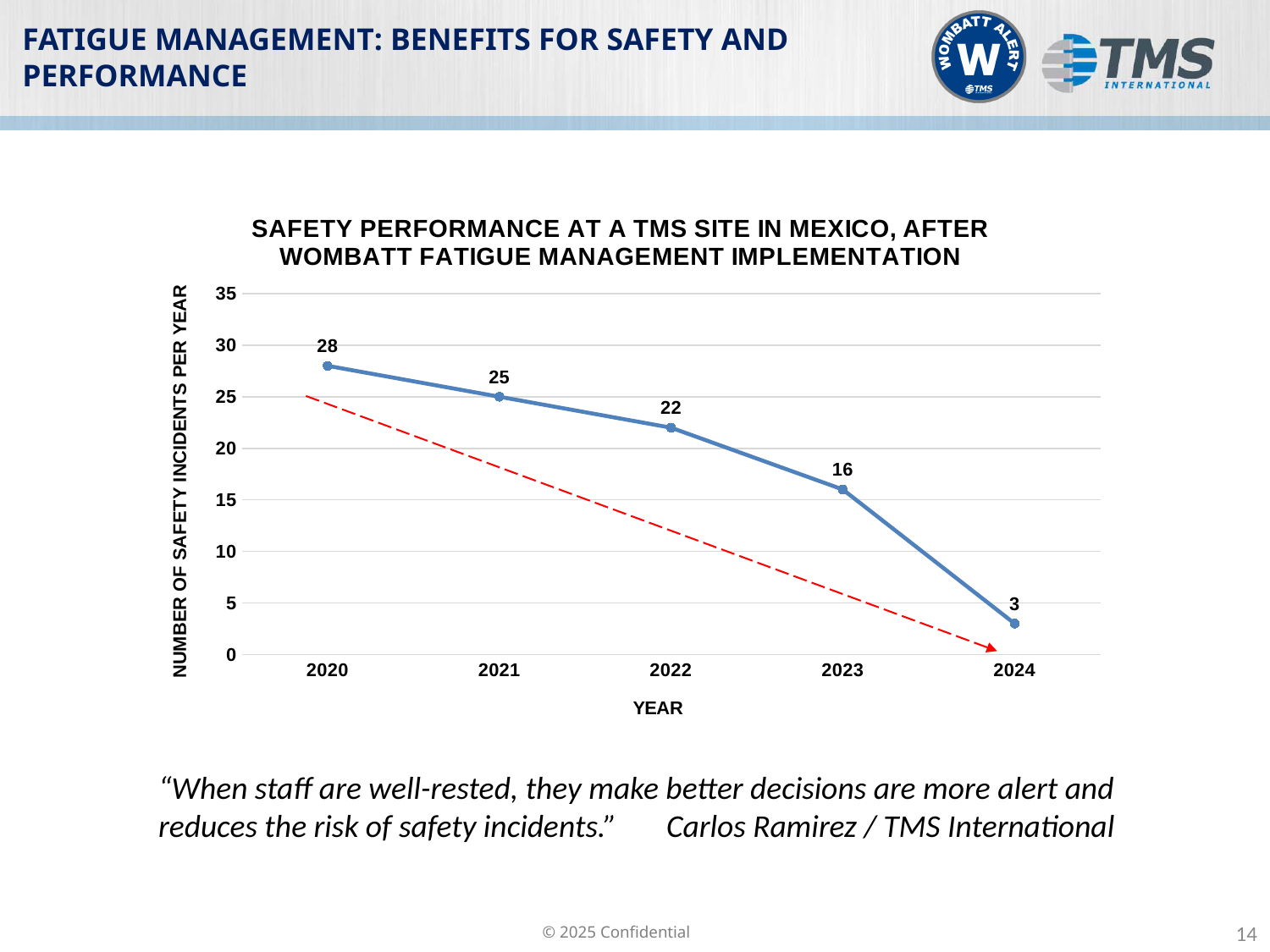
How many years are plotted on the x axis? 5 Do the number of safety incidents rise or fall from 2020 to 2024? fall What is the number of safety incidents per year for 2024? 3 What is the difference in safety incidents between 2020 and 2021? 3 What is the difference in safety incidents between 2023 and 2024? 13 What is the number of safety incidents per year for 2022? 22 Is the value for 2023 greater or less than 20? less What is the number of safety incidents per year for 2020? 28 Which year has the lowest number of safety incidents? 2024 Which year had more safety incidents, 2021 or 2023? 2021 Which year has the highest number of safety incidents? 2020 What kind of chart is shown on the slide? line chart